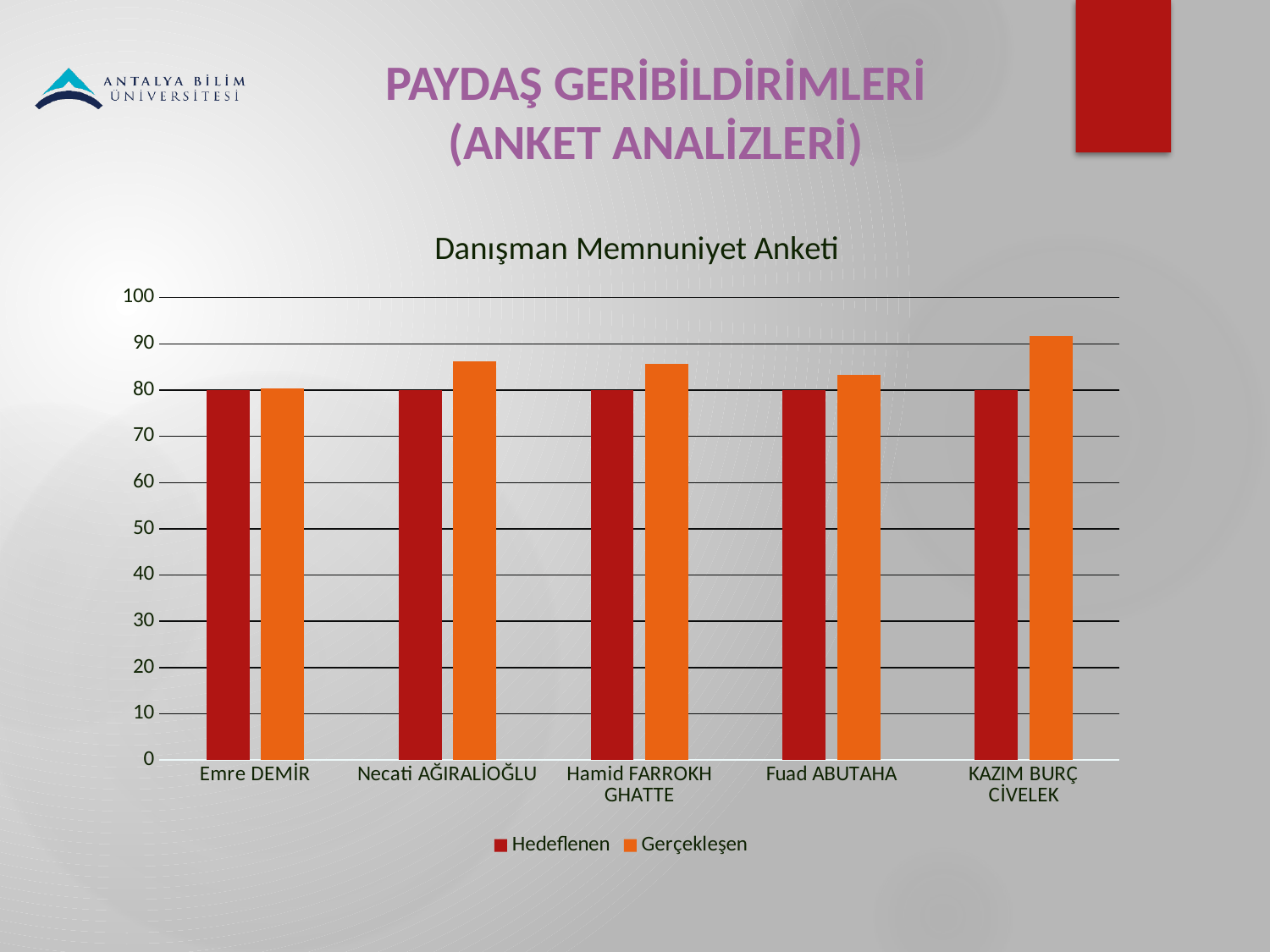
What is the Hedeflenen value for KAZIM BURÇ CİVELEK? 80 What kind of chart is shown on the slide? bar chart How many categories (advisors) are shown on the x axis? 5 Which is larger: the Gerçekleşen value for KAZIM BURÇ CİVELEK or for Fuad ABUTAHA? KAZIM BURÇ CİVELEK Is the Gerçekleşen value for Necati AĞIRALİOĞLU greater or less than 80? greater Which advisor has the highest Gerçekleşen value? KAZIM BURÇ CİVELEK Is the Gerçekleşen value for KAZIM BURÇ CİVELEK greater or less than 90? greater What is the title of the chart? Danışman Memnuniyet Anketi What is the Hedeflenen value for Emre DEMİR? 80 How many series does the legend list? 2 Which advisor has the lowest Gerçekleşen value? Emre DEMİR Is the Gerçekleşen value for Fuad ABUTAHA greater or less than 90? less